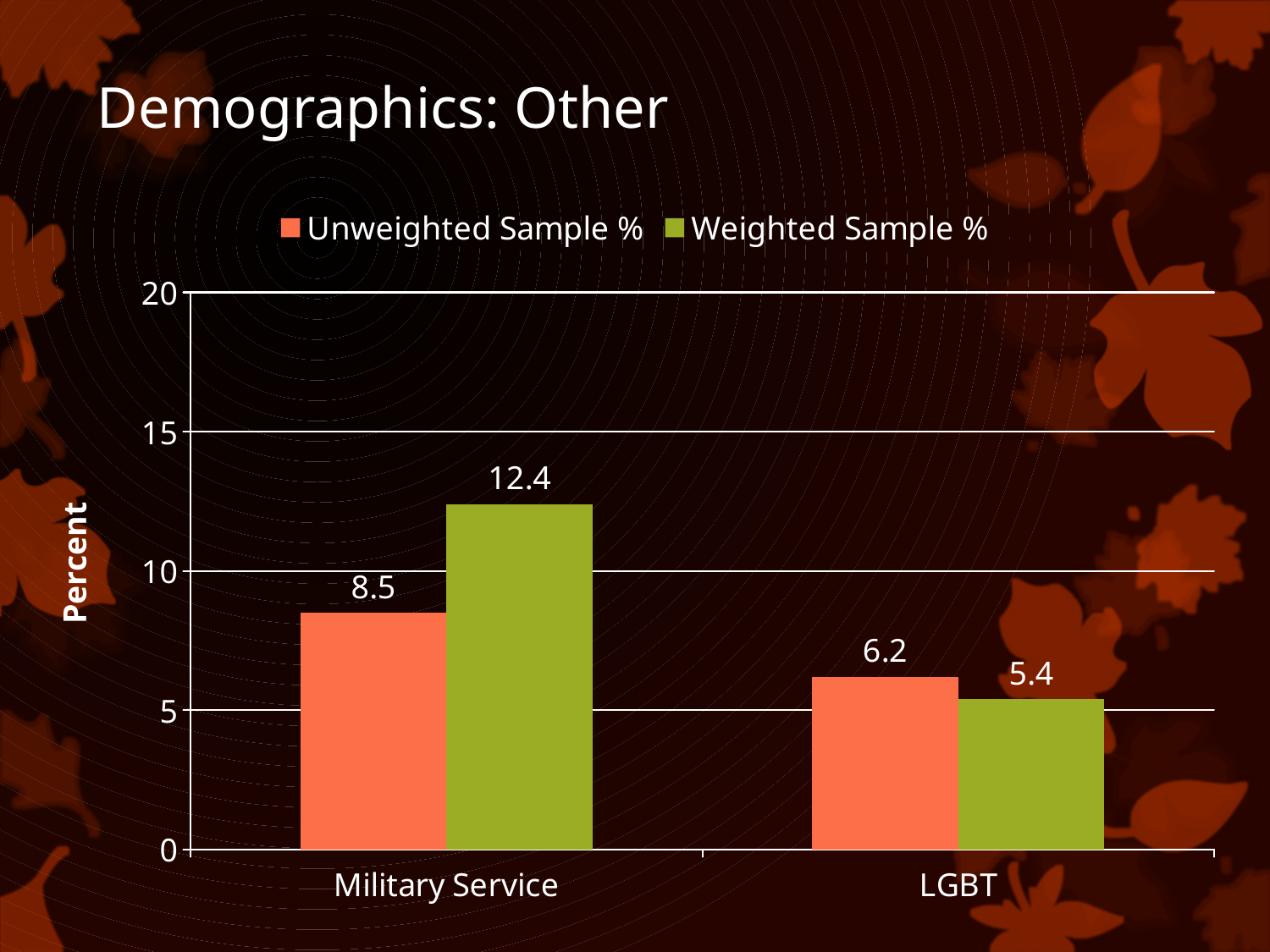
What is the Unweighted Sample % value for Military Service? 8.5 How many series does the legend list? 2 What is the Weighted Sample % value for LGBT? 5.4 For LGBT, which is larger: the Unweighted Sample % or the Weighted Sample %? Unweighted Sample % What is the difference between the Weighted Sample % and Unweighted Sample % values for Military Service? 3.9 Which category has the lowest Weighted Sample % value? LGBT Which category has the highest Weighted Sample % value? Military Service What kind of chart is shown on the slide? bar chart Is the Weighted Sample % value for Military Service greater or less than 10? greater What is the Unweighted Sample % value for LGBT? 6.2 How many categories are shown on the x axis? 2 What is the Weighted Sample % value for Military Service? 12.4